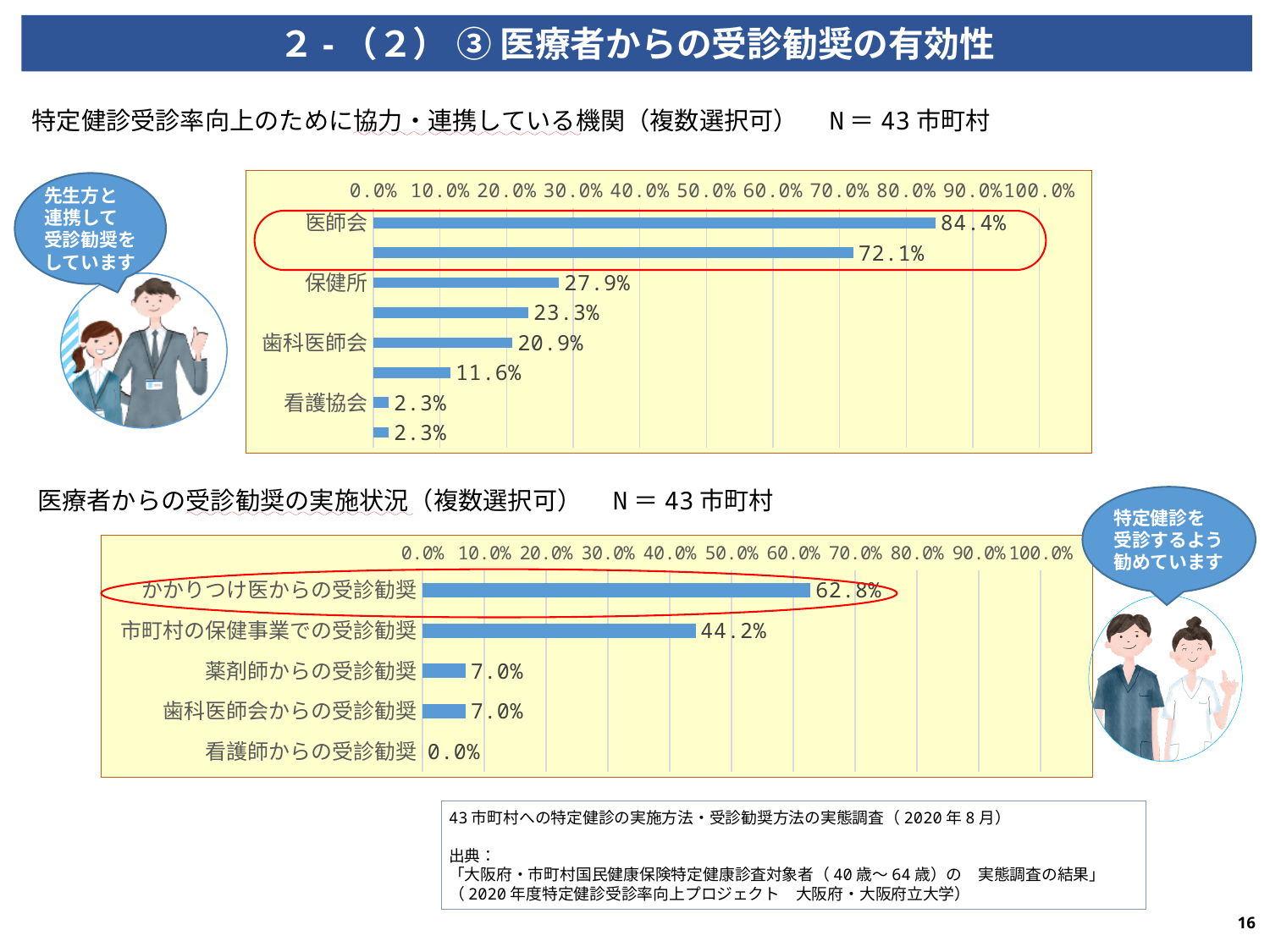
In the bottom chart (医療者からの受診勧奨の実施状況), which category has the lowest value? 看護師からの受診勧奨 In the top chart (特定健診受診率向上のために協力・連携している機関), which category has the highest value? 医師会 In the bottom chart (医療者からの受診勧奨の実施状況), what is the value for 市町村の保健事業での受診勧奨? 44.2% In the top chart (特定健診受診率向上のために協力・連携している機関), what is the difference between the values for 医師会 and 保健所? 56.5% In the top chart (特定健診受診率向上のために協力・連携している機関), what is the value for 医師会? 84.4% In the bottom chart (医療者からの受診勧奨の実施状況), which is larger: かかりつけ医からの受診勧奨 or 市町村の保健事業での受診勧奨? かかりつけ医からの受診勧奨 In the bottom chart (医療者からの受診勧奨の実施状況), how many categories are shown? 5 In the top chart (特定健診受診率向上のために協力・連携している機関), what is the value for 歯科医師会? 20.9% In the bottom chart (医療者からの受診勧奨の実施状況), what is the value for かかりつけ医からの受診勧奨? 62.8% What type of chart is the bottom chart (医療者からの受診勧奨の実施状況)? Bar chart In the top chart (特定健診受診率向上のために協力・連携している機関), what is the value for 保健所? 27.9% In the top chart (特定健診受診率向上のために協力・連携している機関), how many bars are plotted? 8